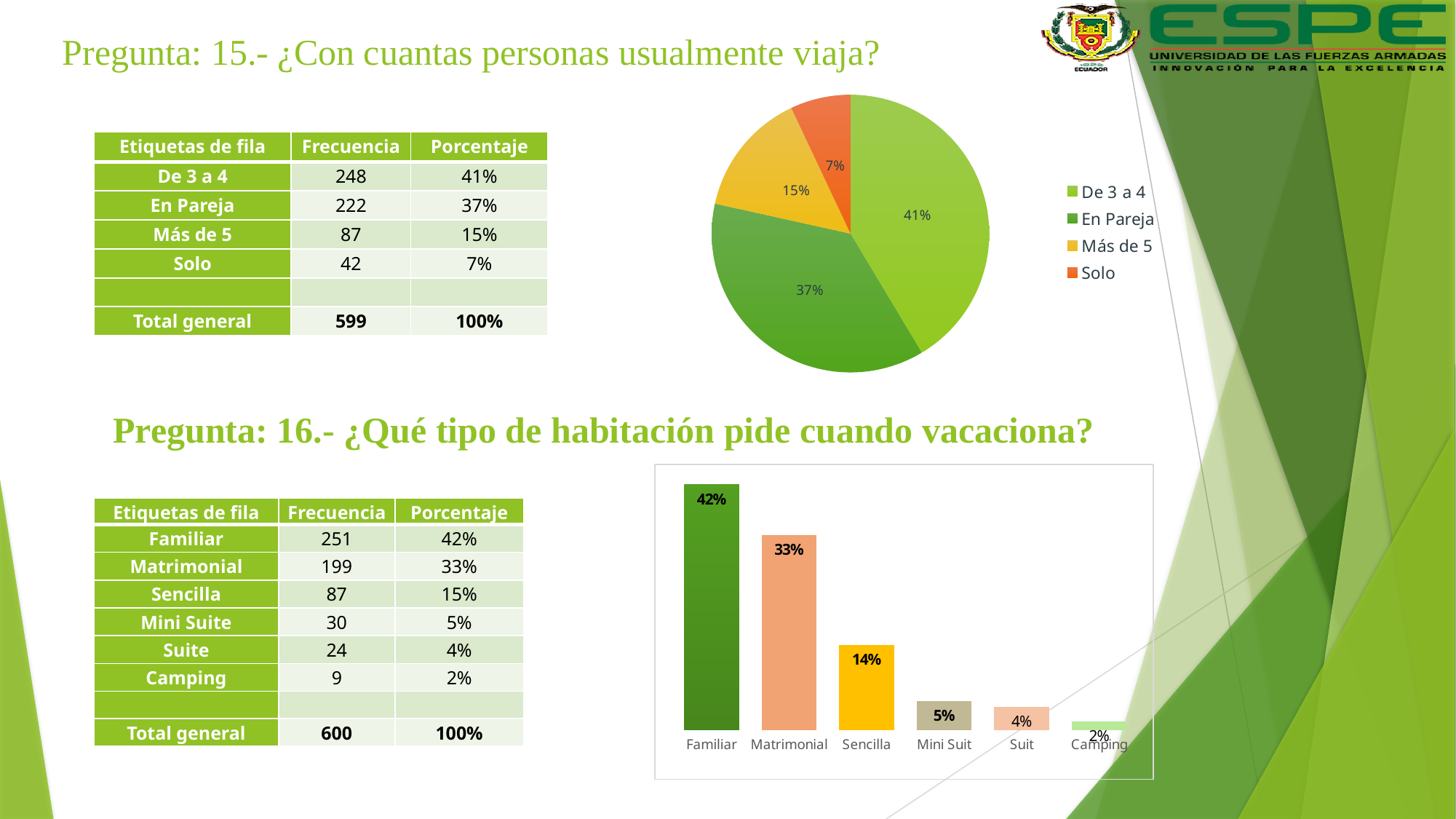
In the bar chart at the bottom of the slide, what is the value for 'Matrimonial'? 33% In the pie chart at the top of the slide, what share does the 'De 3 a 4' slice represent? 41% In the bar chart at the bottom of the slide, which category has the lowest value? Camping In the pie chart at the top of the slide, what is the difference in percentage points between 'En Pareja' and 'Más de 5'? 22 In the pie chart at the top of the slide, which category has the smallest slice? Solo In the pie chart at the top of the slide, which category has the largest slice? De 3 a 4 What kind of chart is shown at the bottom of the slide? Bar chart In the pie chart at the top of the slide, how many categories does the legend list? 4 In the bar chart at the bottom of the slide, how many categories are shown on the x axis? 6 In the bar chart at the bottom of the slide, which is larger, 'Mini Suit' or 'Suit'? Mini Suit In the pie chart at the top of the slide, what share does the 'Solo' slice represent? 7% In the bar chart at the bottom of the slide, what is the value for 'Sencilla'? 14%